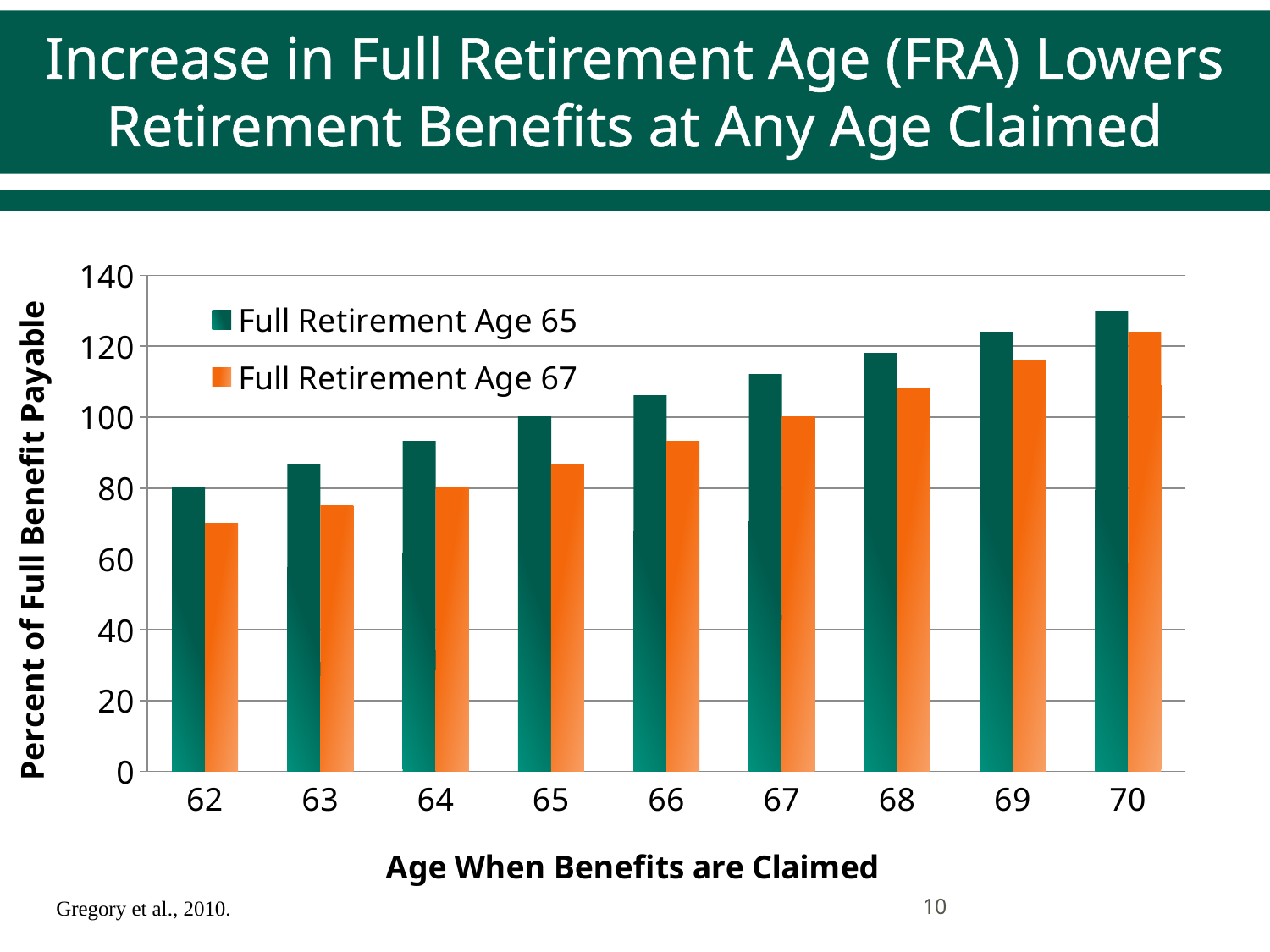
What kind of chart is shown on the slide? bar chart What is the value for Full Retirement Age 65 at age 65? 100 What is the value for Full Retirement Age 67 at age 64? 80 What is the value for Full Retirement Age 65 at age 62? 80 What is the value for Full Retirement Age 67 at age 67? 100 How many series does the legend list? 2 At which claiming age is the Full Retirement Age 67 series lowest? 62 At which claiming age is the Full Retirement Age 65 series highest? 70 How many claiming ages are shown on the x axis? 9 Do the values rise or fall as the claiming age increases? rise Is the value for Full Retirement Age 67 at age 62 greater or less than 80? less Is the value for Full Retirement Age 65 at age 70 greater or less than 120? greater